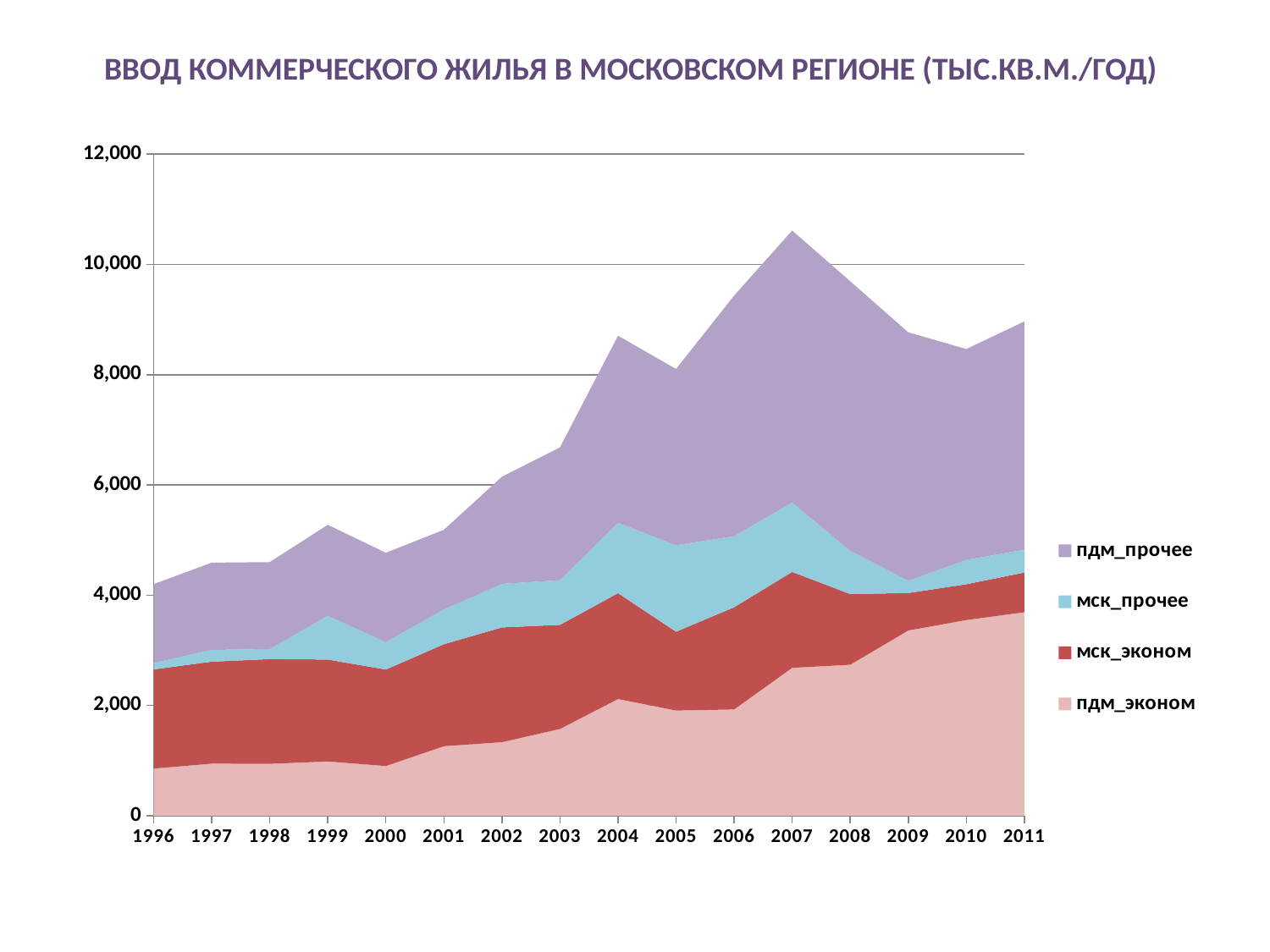
How many series does the legend list? 4 Does the пдм_эконом series generally rise or fall from 1996 to 2011? Rise Is the total value for 2011 greater or less than 10,000? less Which series is shown at the top of the stack in purple? пдм_прочее Is the total value for 2007 greater or less than 10,000? greater In which year is the total commercial housing commissioned the lowest? 1996 Which year has a larger total: 2007 or 2011? 2007 How many years are shown along the x axis? 16 In which year is the total commercial housing commissioned the highest? 2007 Is the value of пдм_эконом in 2011 greater or less than 2,000? greater What kind of chart is shown on the slide? Stacked area chart